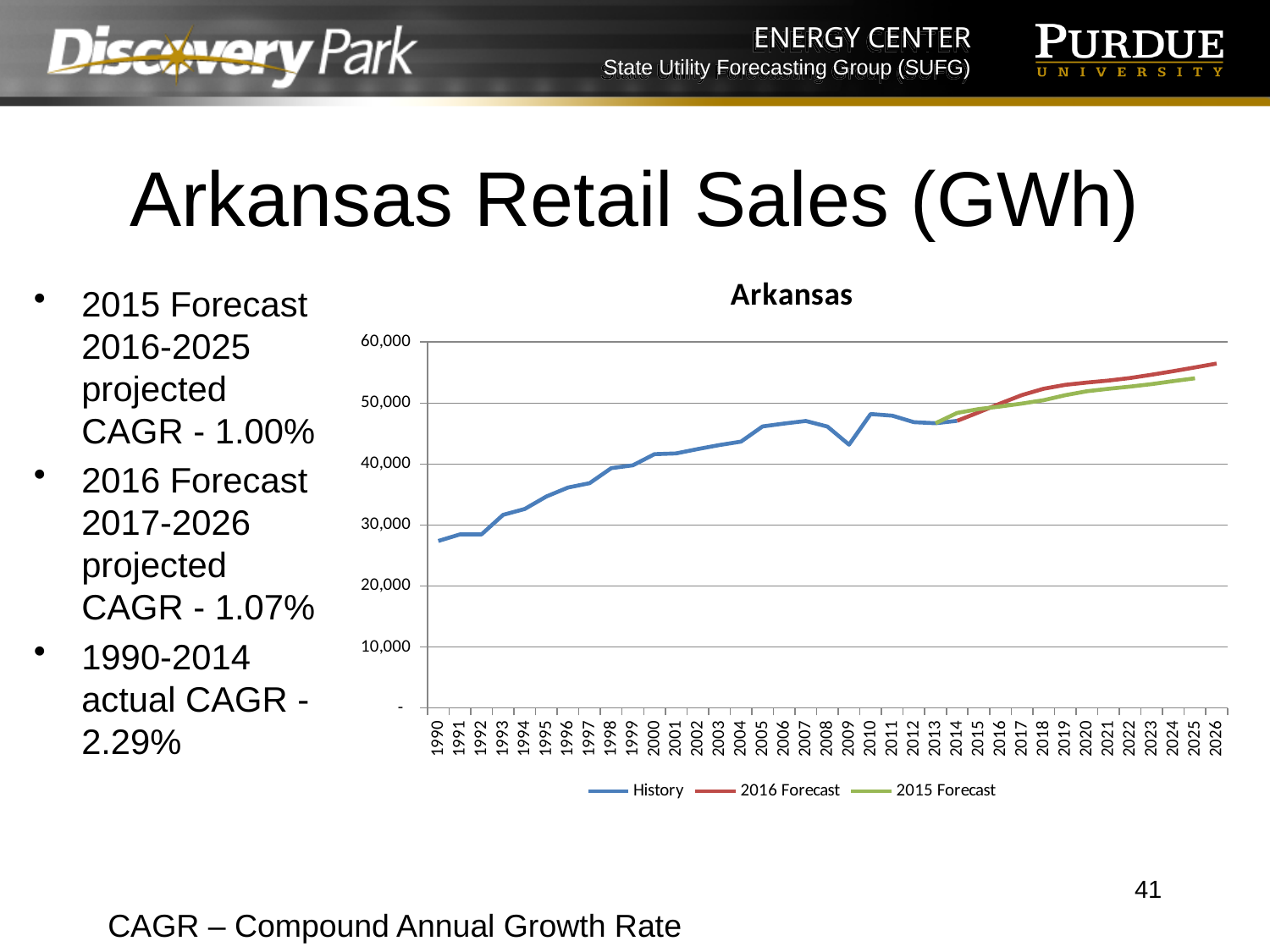
In 2025, which series is higher: 2016 Forecast or 2015 Forecast? 2016 Forecast How many series does the chart legend list? 3 What is the title of the chart? Arkansas What kind of chart is shown on the slide? line chart Is the History value for 2009 greater or less than 40,000? greater Is the History value for 1995 greater or less than 30,000? greater Is the History value for 2007 greater or less than 50,000? less Does the History series generally rise or fall from 1990 to 2014? rise What colour is the History line in the chart? blue How many years are shown on the x axis of the chart? 37